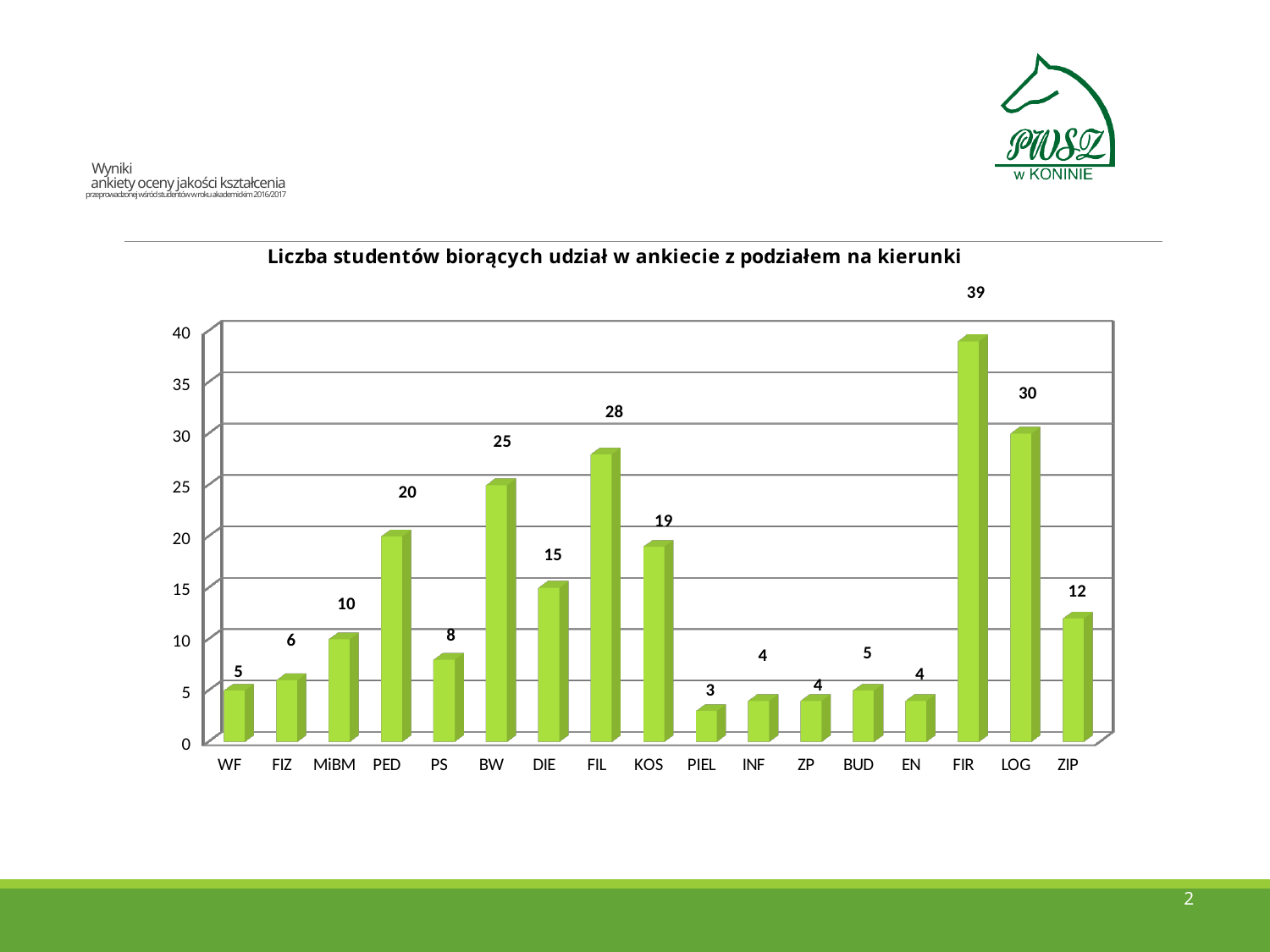
What is the difference between the values for FIR and LOG? 9 Which category has the highest value? FIR What is the difference between the values for FIL and KOS? 9 Which is larger, the value for PED or the value for DIE? PED What is the title of the chart? Liczba studentów biorących udział w ankiecie z podziałem na kierunki What is the value for PIEL? 3 What is the value for BW? 25 What kind of chart is shown on the slide? bar chart Which category has the lowest value? PIEL How many categories are shown on the x axis? 17 Is the value for LOG greater or less than 25? greater What is the value for FIR? 39